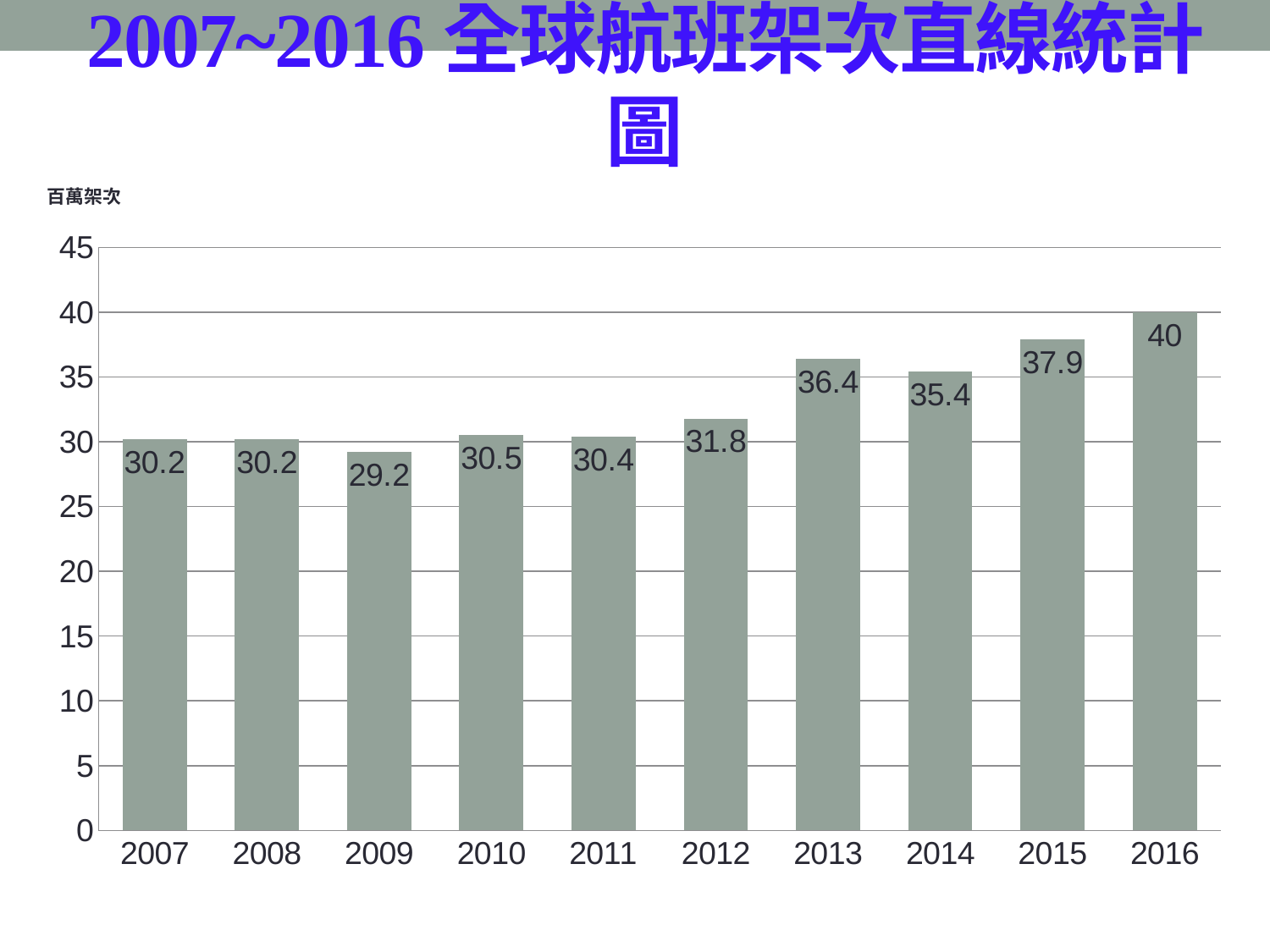
What unit label is shown above the y axis? 百萬架次 Which year has the lowest value? 2009 What kind of chart is this? bar chart What is the value for 2009? 29.2 Which year has the highest value? 2016 How many years are shown on the x axis? 10 What is the difference between the values for 2016 and 2007? 9.8 What is the value for 2013? 36.4 Is the value for 2012 greater or less than 30? greater What is the value for 2016? 40 Which is larger, the value for 2015 or the value for 2014? 2015 What is the difference between the values for 2013 and 2014? 1